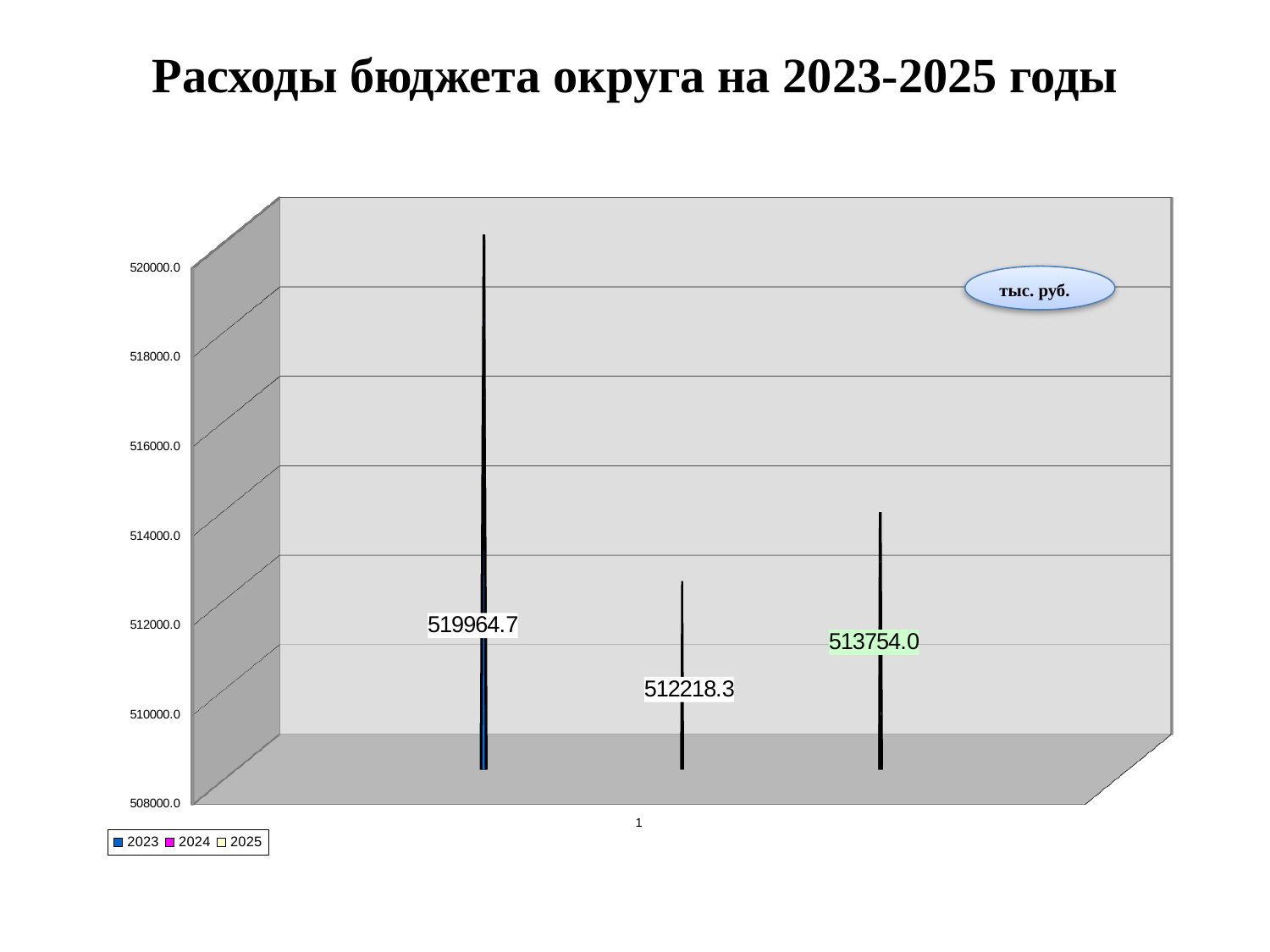
What unit is indicated in the oval label on the chart? тыс. руб. What is the title of the chart? Расходы бюджета округа на 2023-2025 годы What is the difference between the values for 2025 and 2024? 1535.7 Which year has the lowest value? 2024 Which is larger, the value for 2024 or the value for 2025? 2025 What is the value for 2024? 512218.3 How many series does the legend list? 3 What is the value for 2025? 513754.0 What is the difference between the values for 2023 and 2024? 7746.4 Which year has the highest value? 2023 What kind of chart is shown on the slide? Bar chart What is the value for 2023? 519964.7